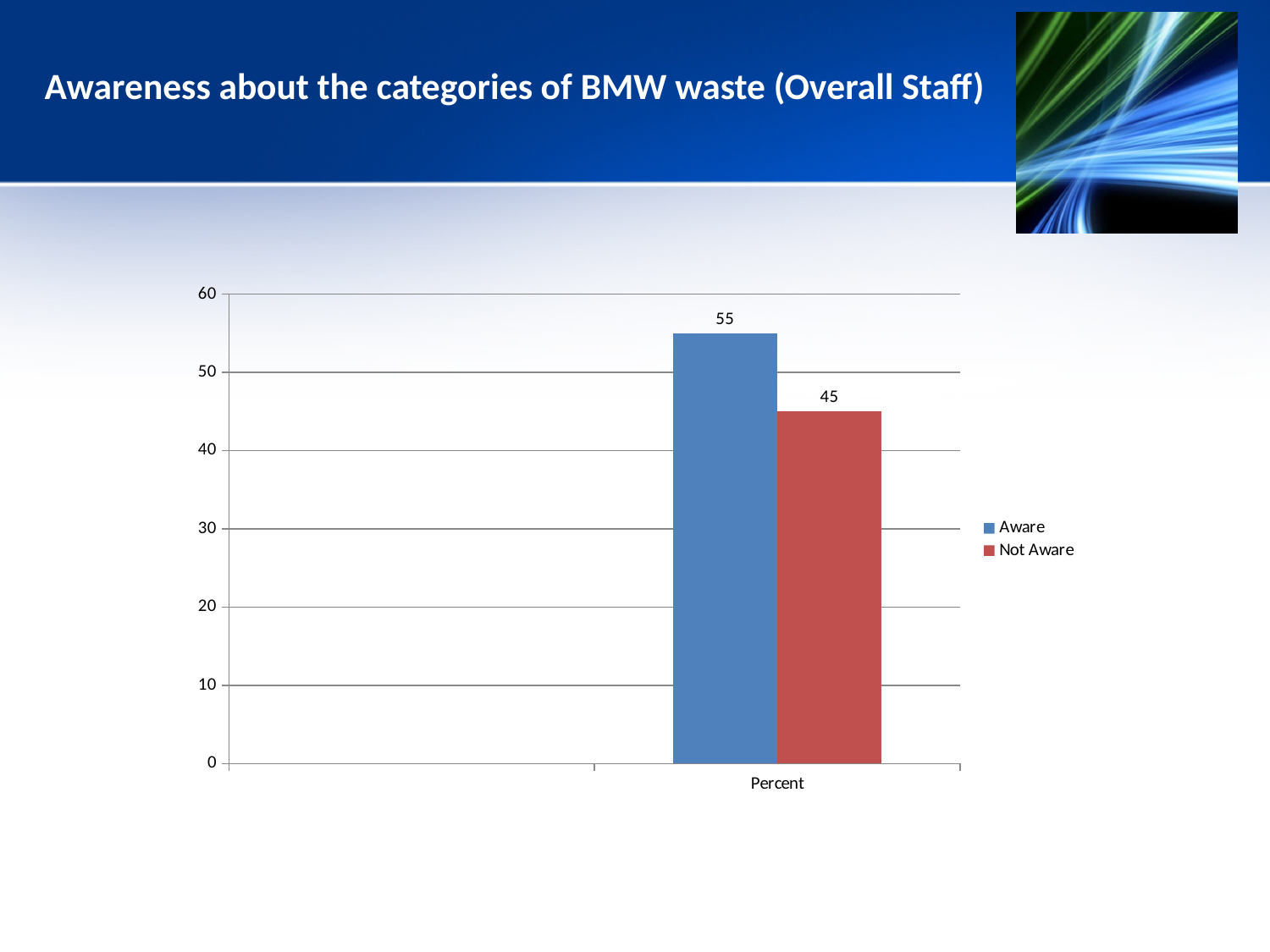
Which series has the lowest value? Not Aware Is the value for Aware greater or less than 50? greater What kind of chart is shown on the slide? Bar chart Is the value for Not Aware greater or less than 50? less What is the maximum value shown on the y axis? 60 What is the label on the x axis category? Percent What is the value for Aware? 55 What colour is the Not Aware bar? Red What is the value for Not Aware? 45 Which series has the higher value, Aware or Not Aware? Aware What is the difference between the Aware and Not Aware values? 10 How many series does the legend list? 2